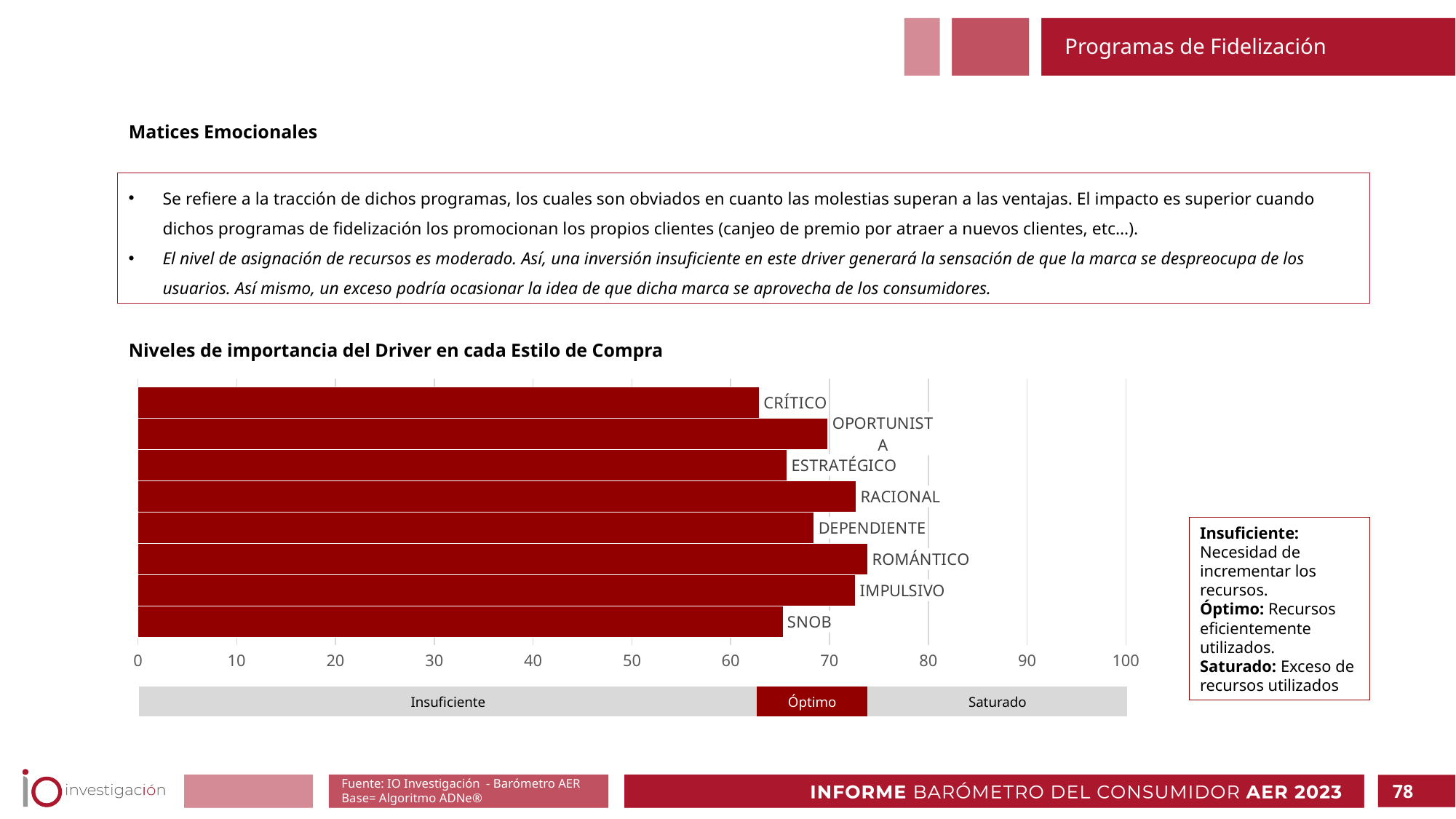
Is the value for SNOB greater or less than 70? less Is the value for RACIONAL greater or less than 70? greater Is the value for ROMÁNTICO greater or less than 70? greater Which has a larger value, RACIONAL or SNOB? RACIONAL Which has a larger value, OPORTUNISTA or CRÍTICO? OPORTUNISTA What is the maximum value shown on the horizontal axis of the bar chart? 100 Which has a larger value, ROMÁNTICO or CRÍTICO? ROMÁNTICO How many purchase styles (categories) are plotted in the bar chart? 8 What are the three zones labelled in the band below the bar chart? Insuficiente, Óptimo, Saturado What kind of chart is shown under "Niveles de importancia del Driver en cada Estilo de Compra"? Bar chart